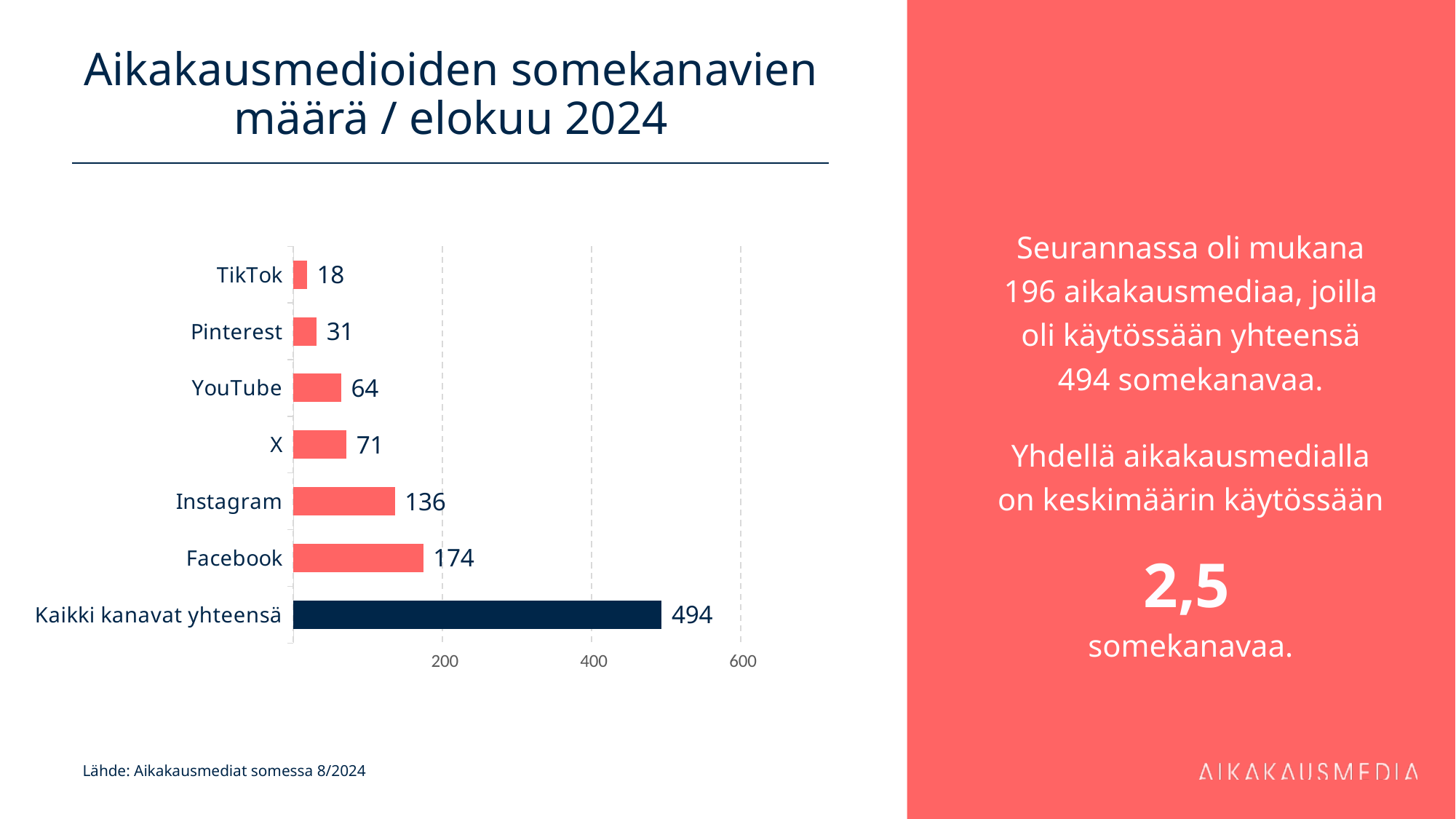
Is the value for Facebook greater or less than 200? less What is the value for TikTok? 18 What is the value for Instagram? 136 What is the title of the chart? Aikakausmedioiden somekanavien määrä / elokuu 2024 What is the value for Facebook? 174 Which is larger, the value for X or the value for YouTube? X What kind of chart is shown on the slide? bar chart What is the difference between the values for Facebook and Instagram? 38 Which category has the lowest value? TikTok How many categories are shown in the chart? 7 What is the value for Kaikki kanavat yhteensä? 494 Which individual channel (excluding the total bar) has the highest value? Facebook